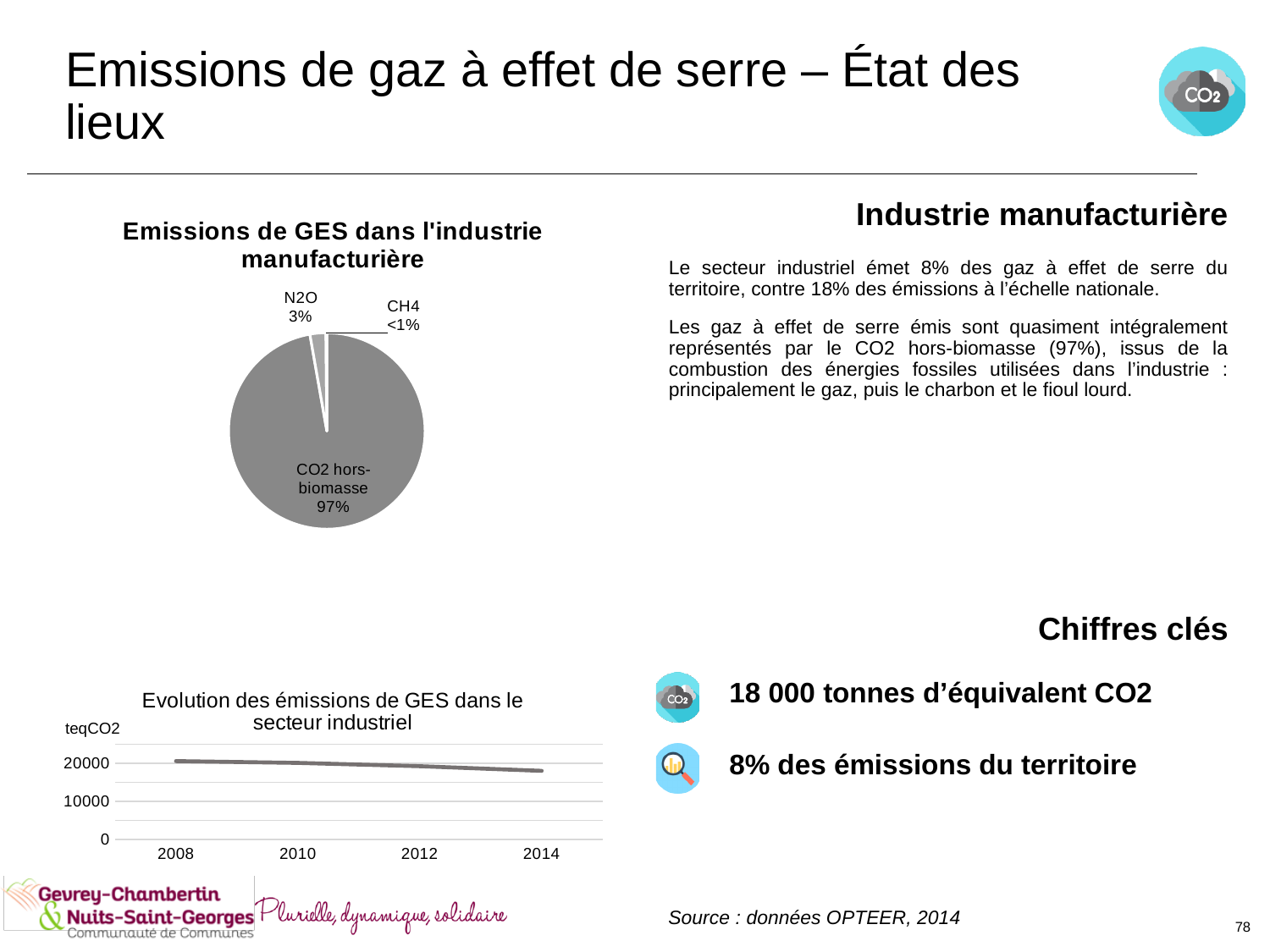
In the pie chart 'Emissions de GES dans l'industrie manufacturière', which gas has the largest slice? CO2 hors-biomasse In the chart 'Evolution des émissions de GES dans le secteur industriel', do emissions rise or fall from 2008 to 2014? Fall In the pie chart 'Emissions de GES dans l'industrie manufacturière', what share is CH4? <1% In the pie chart 'Emissions de GES dans l'industrie manufacturière', which slice is larger, N2O or CH4? N2O In the chart 'Evolution des émissions de GES dans le secteur industriel', is the value for 2014 greater or less than 20000? less How many slices does the pie chart 'Emissions de GES dans l'industrie manufacturière' have? 3 In the pie chart 'Emissions de GES dans l'industrie manufacturière', which gas has the smallest slice? CH4 What unit is shown on the y axis of the chart 'Evolution des émissions de GES dans le secteur industriel'? teqCO2 In the pie chart 'Emissions de GES dans l'industrie manufacturière', what share is CO2 hors-biomasse? 97% What kind of chart is 'Evolution des émissions de GES dans le secteur industriel'? Line chart In the pie chart 'Emissions de GES dans l'industrie manufacturière', what share is N2O? 3% What kind of chart is 'Emissions de GES dans l'industrie manufacturière'? Pie chart